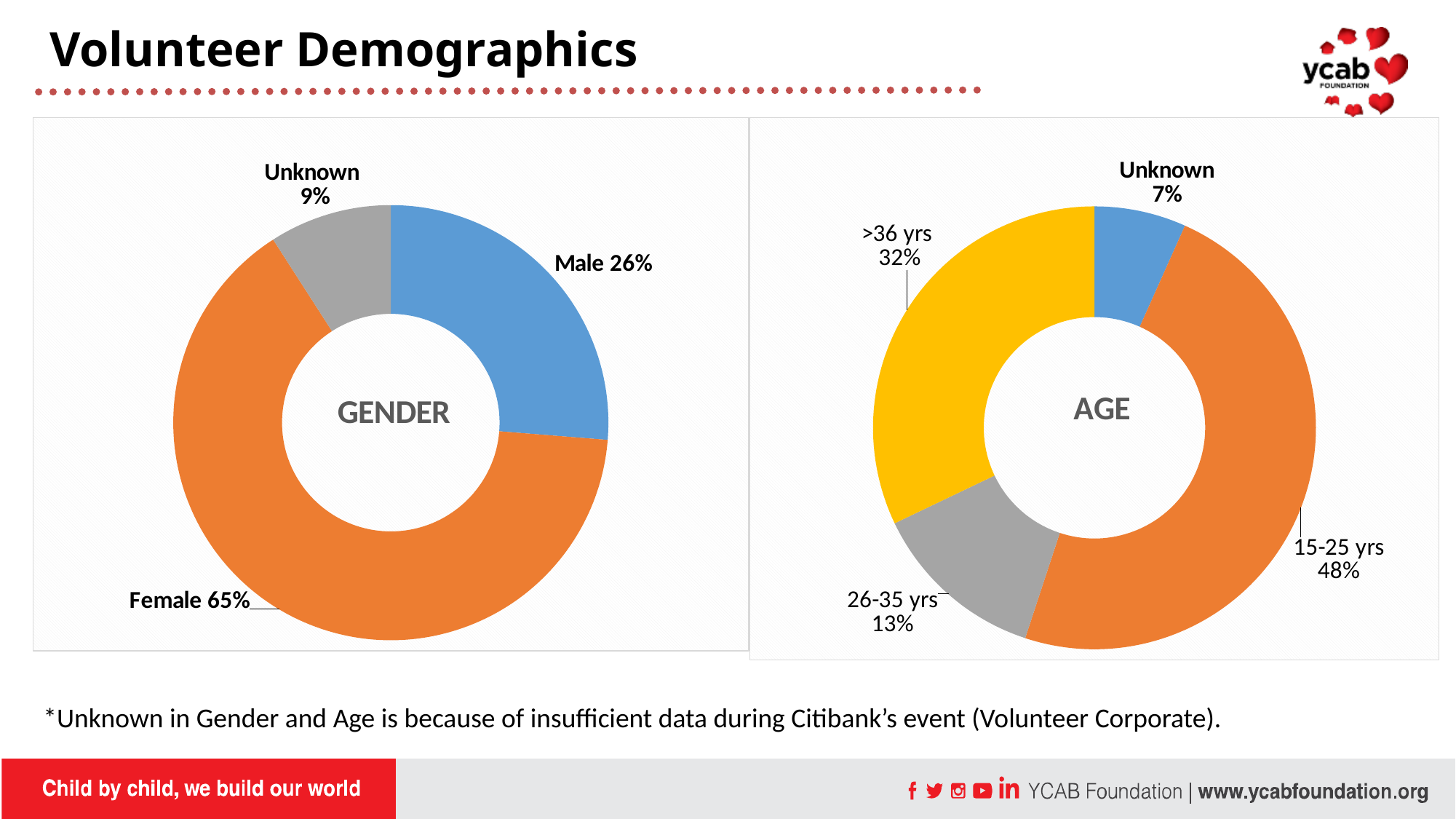
In the AGE chart, which is larger: the share for >36 yrs or the share for 26-35 yrs? >36 yrs How many categories does the AGE chart show? 4 In the AGE chart, what percentage of volunteers are 15-25 yrs? 48% In the GENDER chart, what is the difference in percentage points between Female and Male? 39 What type of chart is the GENDER chart? Doughnut chart In the GENDER chart, which category has the largest share? Female In the AGE chart, what percentage of volunteers are >36 yrs? 32% In the GENDER chart, what percentage is labelled Unknown? 9% In the AGE chart, what percentage of volunteers are 26-35 yrs? 13% In the GENDER chart, what percentage of volunteers are Male? 26% In the AGE chart, which category has the smallest share? Unknown In the GENDER chart, what percentage of volunteers are Female? 65%